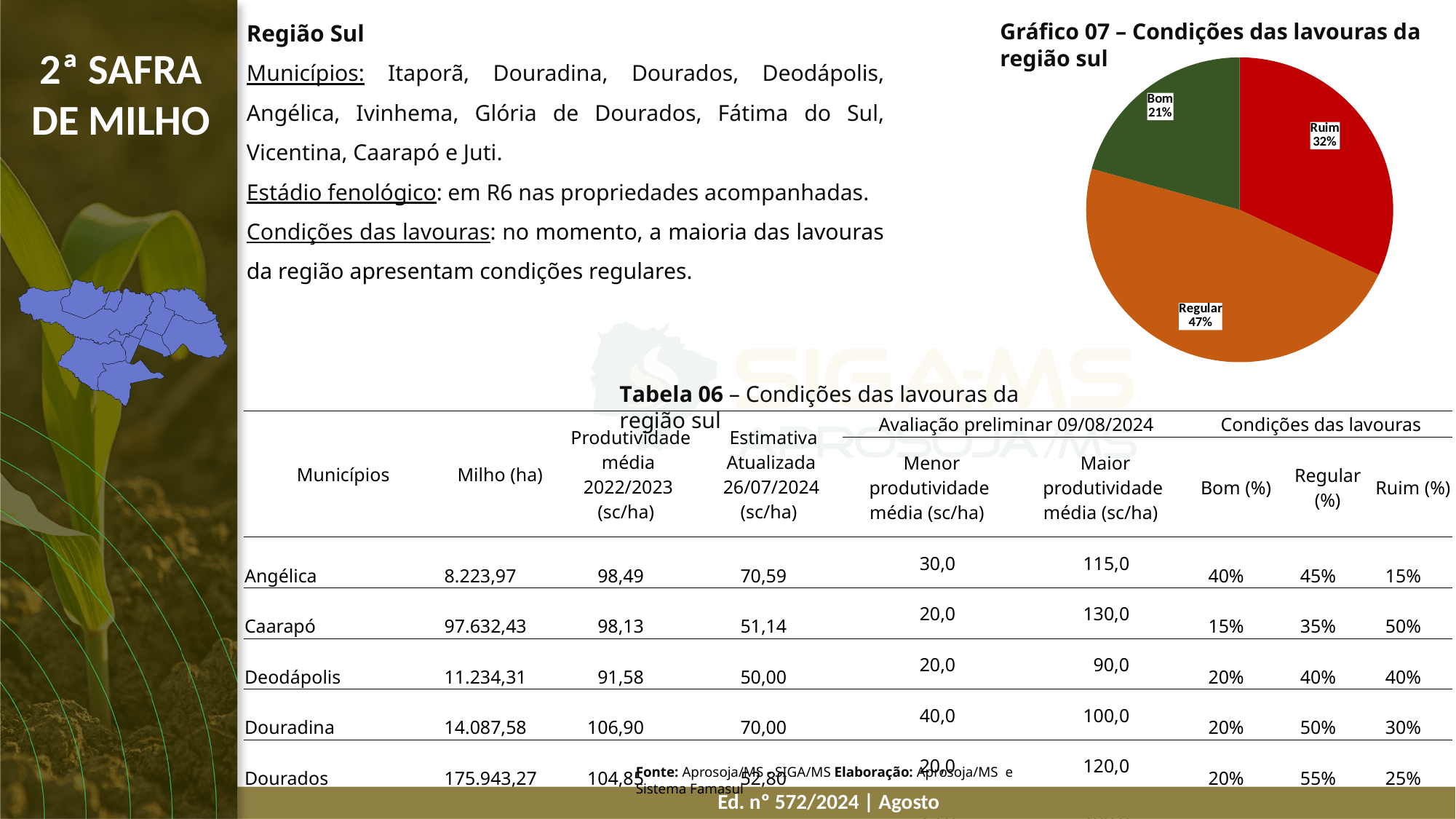
In Gráfico 07, what is the difference in percentage points between the Regular and Ruim slices? 15 Which category has the largest slice in Gráfico 07? Regular What is the title of the pie chart on the slide? Gráfico 07 – Condições das lavouras da região sul In Gráfico 07, what share of the lavouras is classified as Ruim? 32% Which category has the smallest slice in Gráfico 07? Bom In Gráfico 07, what is the difference in percentage points between the Ruim and Bom slices? 11 What kind of chart is Gráfico 07? pie chart In Gráfico 07, what colour is the Regular slice? orange How many slices does the pie in Gráfico 07 have? 3 In Gráfico 07, what share of the lavouras is classified as Regular? 47% In Gráfico 07, which slice is larger, Ruim or Bom? Ruim In Gráfico 07, what share of the lavouras is classified as Bom? 21%